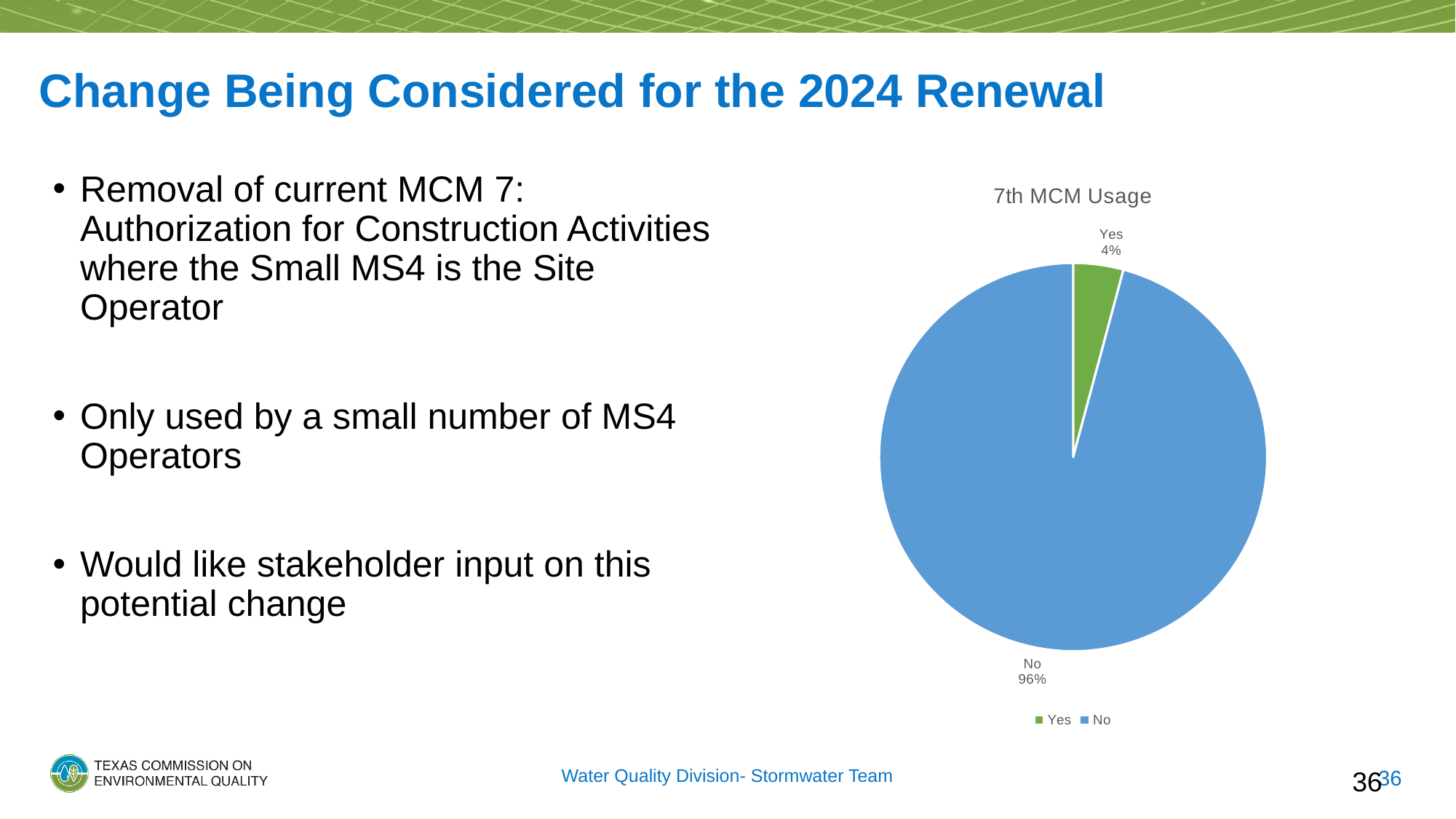
Which is larger, the "Yes" slice or the "No" slice? No What is the title of the chart? 7th MCM Usage What percentage of the pie is labelled "No"? 96% Which slice of the pie is the smallest? Yes How many entries does the legend list? 2 Which slice of the pie is the largest? No What percentage of the pie is labelled "Yes"? 4% What kind of chart is shown on the slide? pie chart What is the difference in percentage points between the "No" slice and the "Yes" slice? 92 What colour is the "Yes" slice? green How many slices does the pie chart have? 2 What share of the pie does the "No" slice represent? 96%